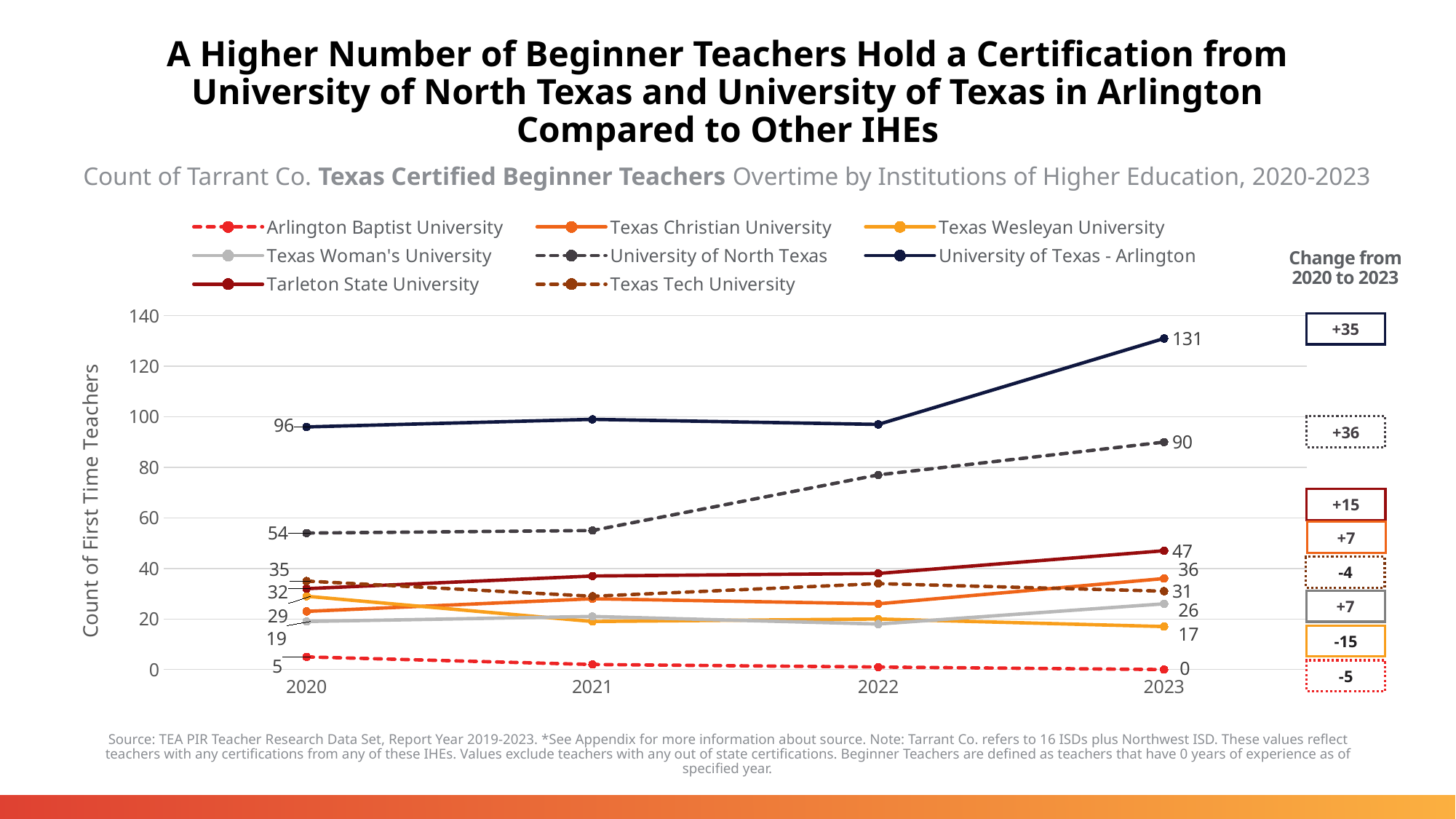
What kind of chart is shown on the slide? line chart What is the value for Texas Wesleyan University in 2023? 17 What is the difference between University of Texas - Arlington and University of North Texas in 2023? 41 How many years are shown on the x axis? 4 Which institution has the lowest value in 2023? Arlington Baptist University Is the value for University of North Texas in 2022 greater or less than 60? greater What is the value for University of Texas - Arlington in 2023? 131 Which is larger in 2023, Tarleton State University or Texas Christian University? Tarleton State University What is the value for University of North Texas in 2020? 54 Does the value for University of North Texas rise or fall from 2020 to 2023? rise How many series does the legend list? 8 Which institution has the highest value in 2023? University of Texas - Arlington